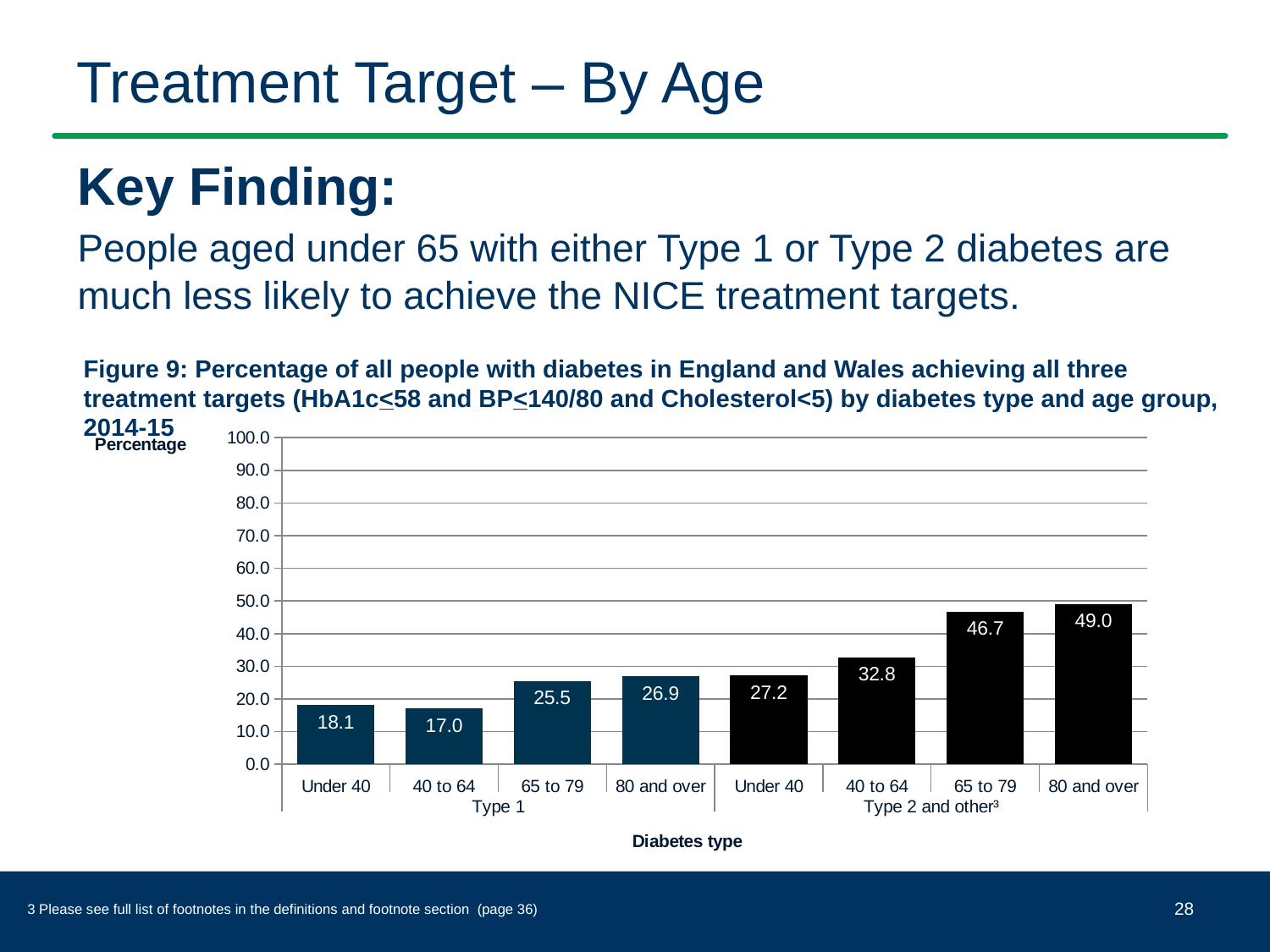
Which is larger: the 'Under 40' value for Type 1 or the 'Under 40' value for Type 2 and other? Under 40, Type 2 and other What is the value for the 'Under 40' age group with Type 1 diabetes? 18.1 What is the value for the '65 to 79' age group in the 'Type 2 and other' group? 46.7 Which bar has the highest value on the chart? 80 and over, Type 2 and other What kind of chart is shown on the slide? Bar chart What is the value for the '80 and over' age group with Type 1 diabetes? 26.9 What is the label of the x axis? Diabetes type Which bar has the lowest value on the chart? 40 to 64, Type 1 Is the value for '65 to 79' in the Type 2 and other group greater or less than 40.0? greater How many bars are plotted on the chart? 8 What is the difference between the '80 and over' value for Type 2 and other and the '80 and over' value for Type 1? 22.1 What is the difference between the '40 to 64' values for Type 2 and other and Type 1? 15.8